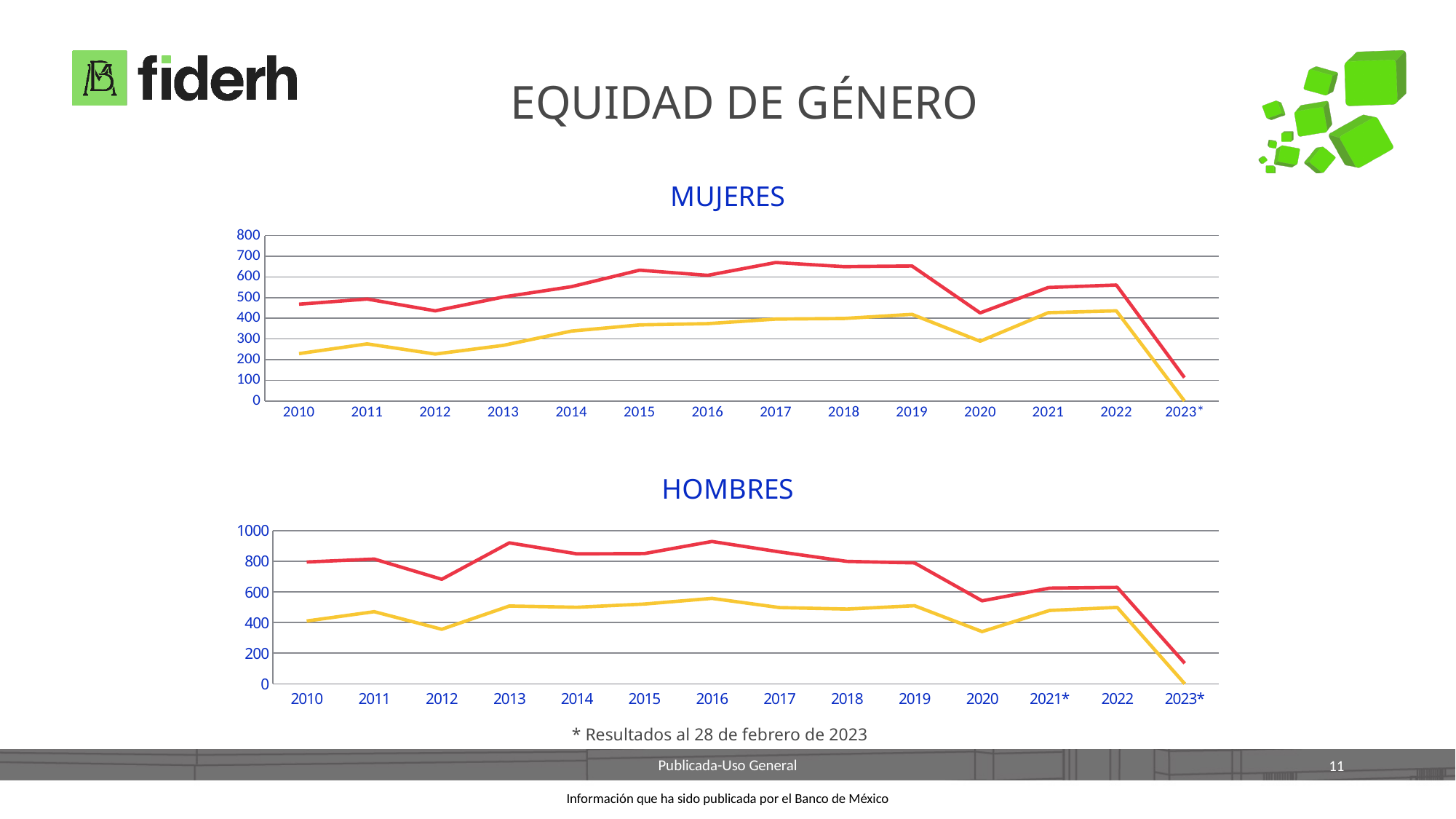
In the HOMBRES chart, is the value of the yellow line for 2012 greater or less than 400? less What kind of chart is the MUJERES chart? line chart How many years are shown on the x axis of the MUJERES chart? 14 In the HOMBRES chart, do the lines rise or fall from 2022 to 2023*? fall In the MUJERES chart, which line is higher in 2017, the red line or the yellow line? the red line What kind of chart is the HOMBRES chart? line chart In the MUJERES chart, is the value of the red line for 2010 greater or less than 400? greater How many years are shown on the x axis of the HOMBRES chart? 14 In the HOMBRES chart, which year has the lowest value for the red line? 2023* In the MUJERES chart, is the value of the yellow line for 2015 greater or less than 400? less How many lines are plotted on the HOMBRES chart? 2